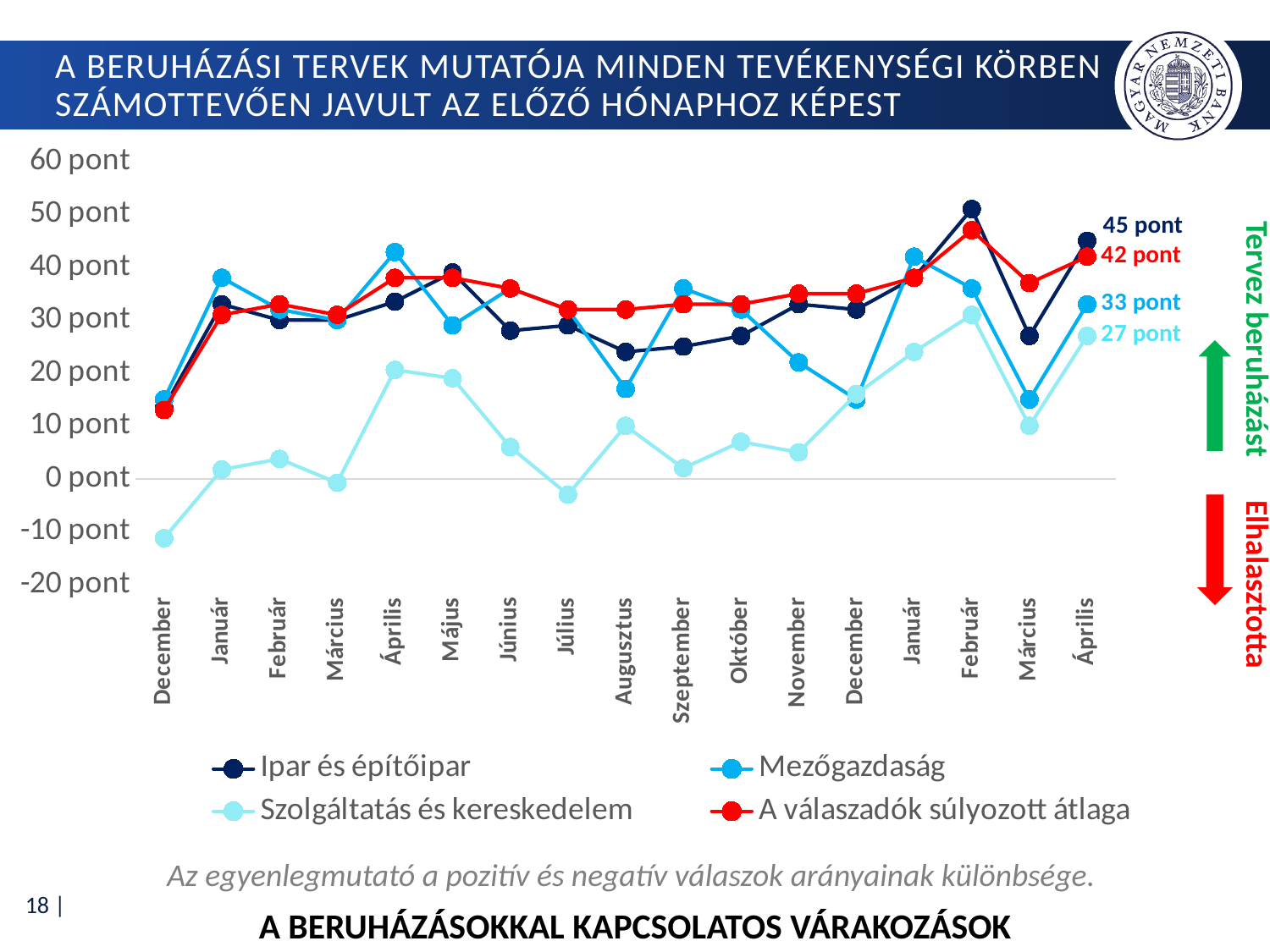
How many months are shown on the x axis? 17 At the final Április point, which is larger: Ipar és építőipar or Mezőgazdaság? Ipar és építőipar What is the value for A válaszadók súlyozott átlaga at the final Április point? 42 pont What is the value for Mezőgazdaság at the final Április point? 33 pont Which series has the lowest value at the final Április point? Szolgáltatás és kereskedelem What is the value for Szolgáltatás és kereskedelem at the final Április point? 27 pont At the final Április point, what is the difference between Ipar és építőipar and Szolgáltatás és kereskedelem? 18 pont Which series has the highest value at the final Április point? Ipar és építőipar What kind of chart is shown on the slide? line chart Is the value for Szolgáltatás és kereskedelem in the first December greater or less than 0 pont? less What is the value for Ipar és építőipar at the final Április point? 45 pont How many series does the legend list? 4